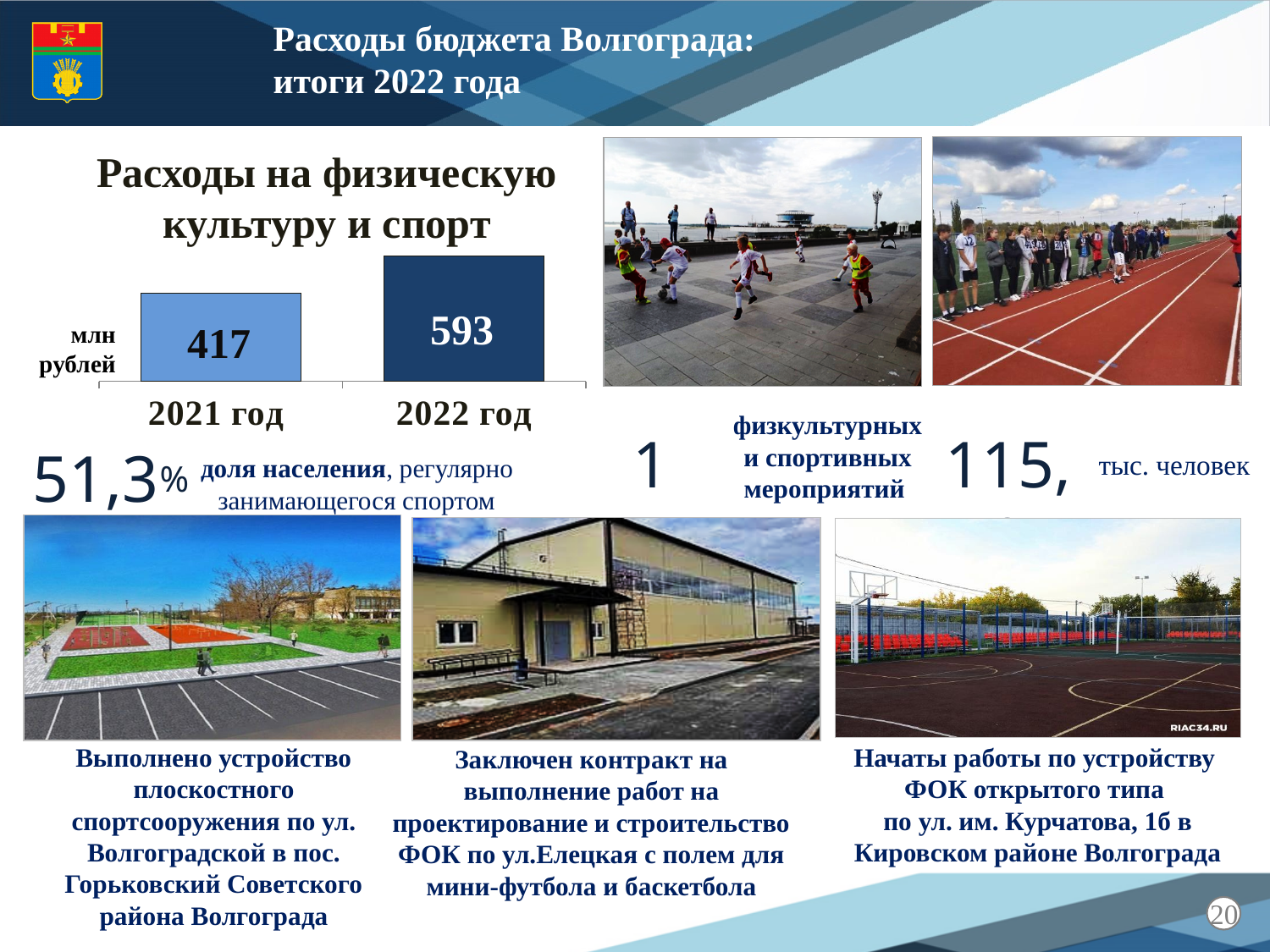
In the chart 'Расходы на физическую культуру и спорт', is the value for 2022 год larger or smaller than the value for 2021 год? larger What is the value for 2022 год in the chart 'Расходы на физическую культуру и спорт'? 593 How many categories (years) are shown in the chart 'Расходы на физическую культуру и спорт'? 2 What is the value for 2021 год in the chart 'Расходы на физическую культуру и спорт'? 417 What is the difference between the 2022 год and 2021 год values in the chart 'Расходы на физическую культуру и спорт'? 176 What is the title of the bar chart on the slide? Расходы на физическую культуру и спорт Which year has the higher value in the chart 'Расходы на физическую культуру и спорт'? 2022 год Which year has the lower value in the chart 'Расходы на физическую культуру и спорт'? 2021 год What unit is indicated on the axis of the chart 'Расходы на физическую культуру и спорт'? млн рублей What kind of chart is 'Расходы на физическую культуру и спорт'? bar chart Do the values in the chart 'Расходы на физическую культуру и спорт' rise or fall from 2021 год to 2022 год? rise